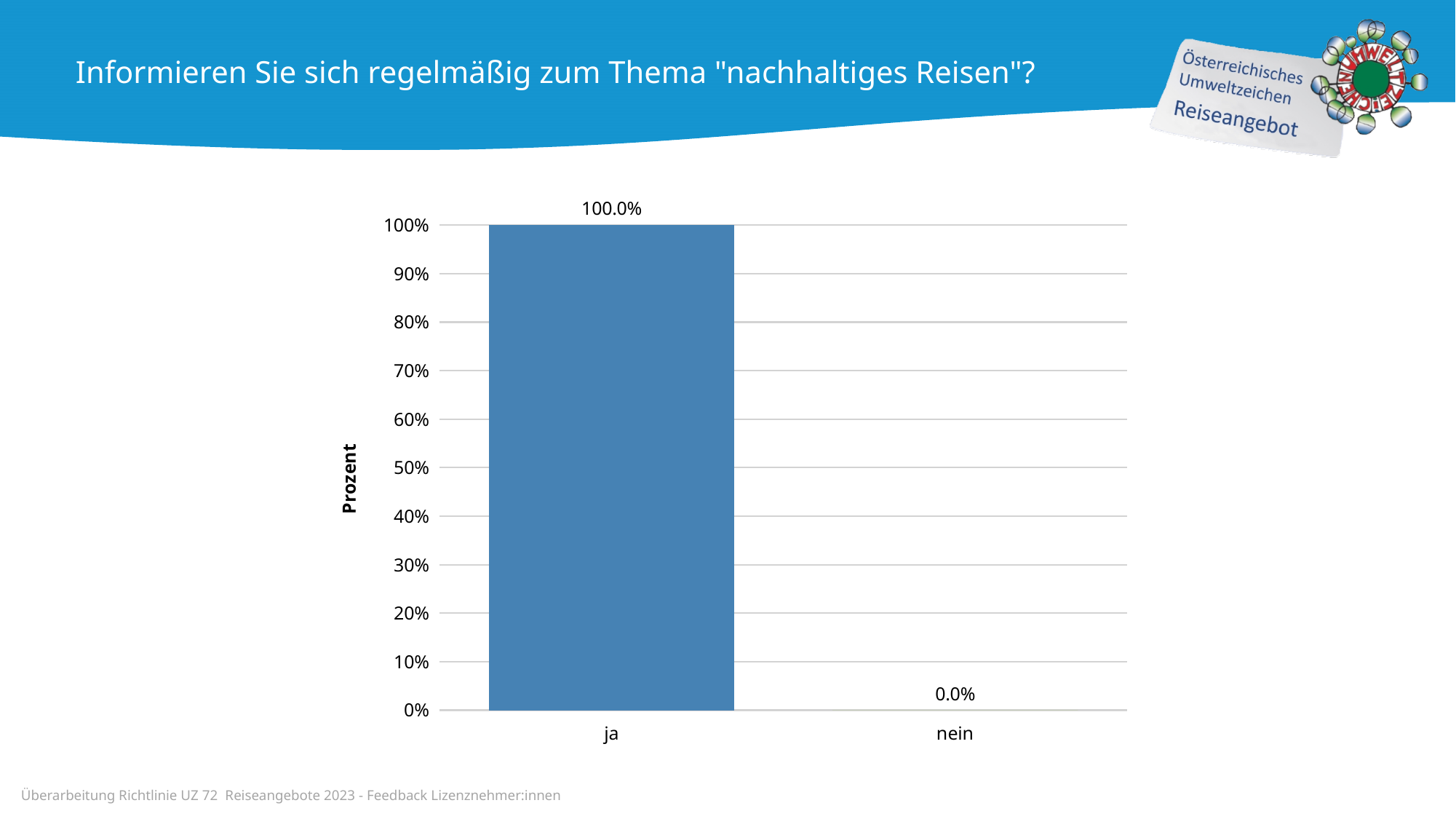
Which category has the highest value? ja Which category has the lowest value? nein Is the value for "ja" greater or less than 50%? greater What is the value for "ja"? 100.0% What is the label of the vertical axis? Prozent What is the value for "nein"? 0.0% What kind of chart is shown on the slide? bar chart What is the difference between the values for "ja" and "nein"? 100.0% How many categories are shown on the x axis? 2 Which is larger, the value for "ja" or the value for "nein"? ja What is the highest tick value shown on the vertical axis? 100%